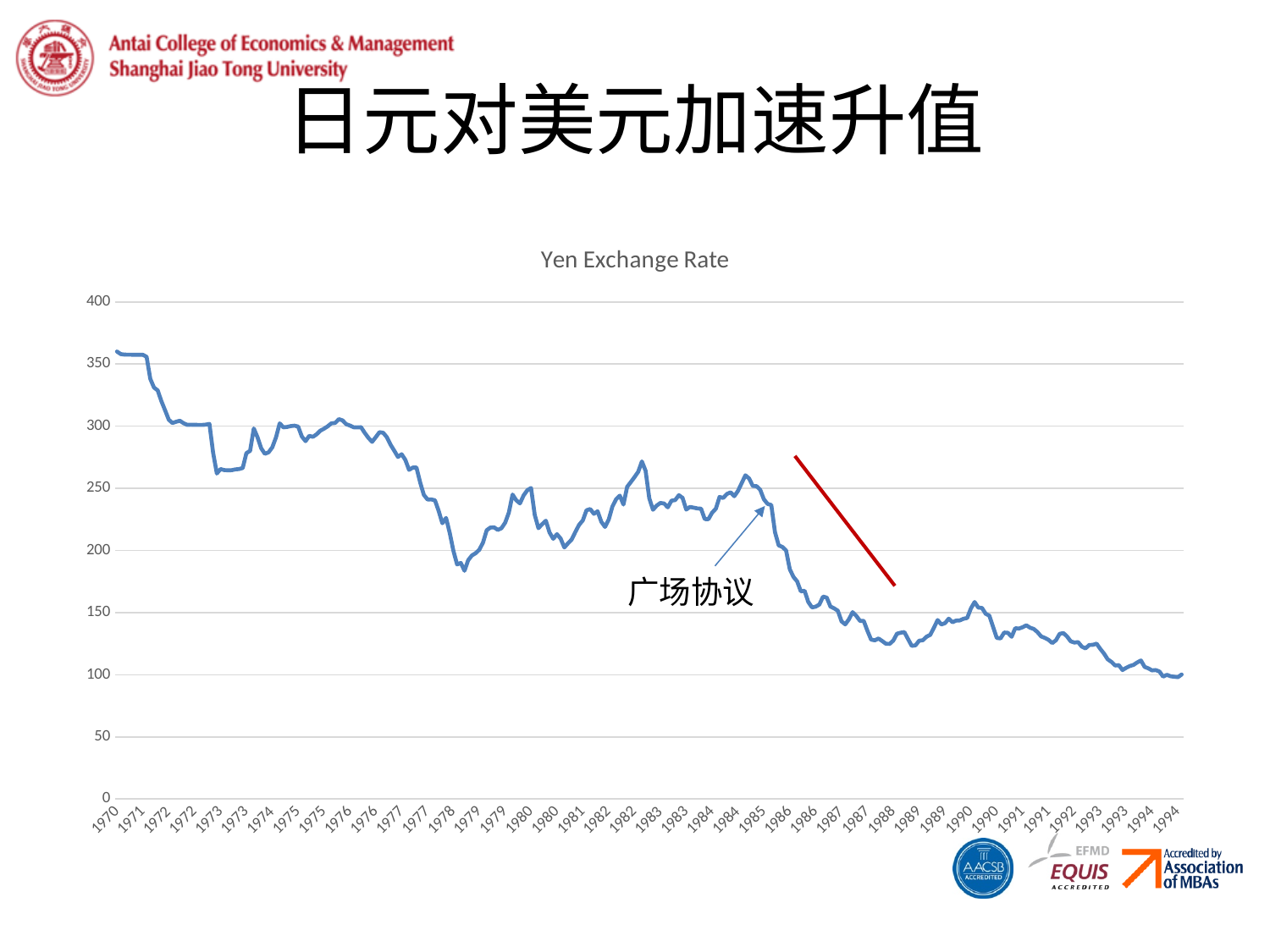
Is the value in 1987 greater or less than 200? less Which event is annotated with an arrow on the chart? 广场协议 In which year does the line reach its highest value? 1970 What kind of chart is shown on the slide? line chart Overall, does the yen exchange rate rise or fall from 1970 to 1994? fall Is the value at the end of 1994 greater or less than 150? less Is the value in 1972 greater or less than 250? greater In which year does the line reach its lowest value? 1994 What is the title of the chart? Yen Exchange Rate Is the value in 1970 larger than the value in 1994? yes What is the highest value shown on the vertical axis? 400